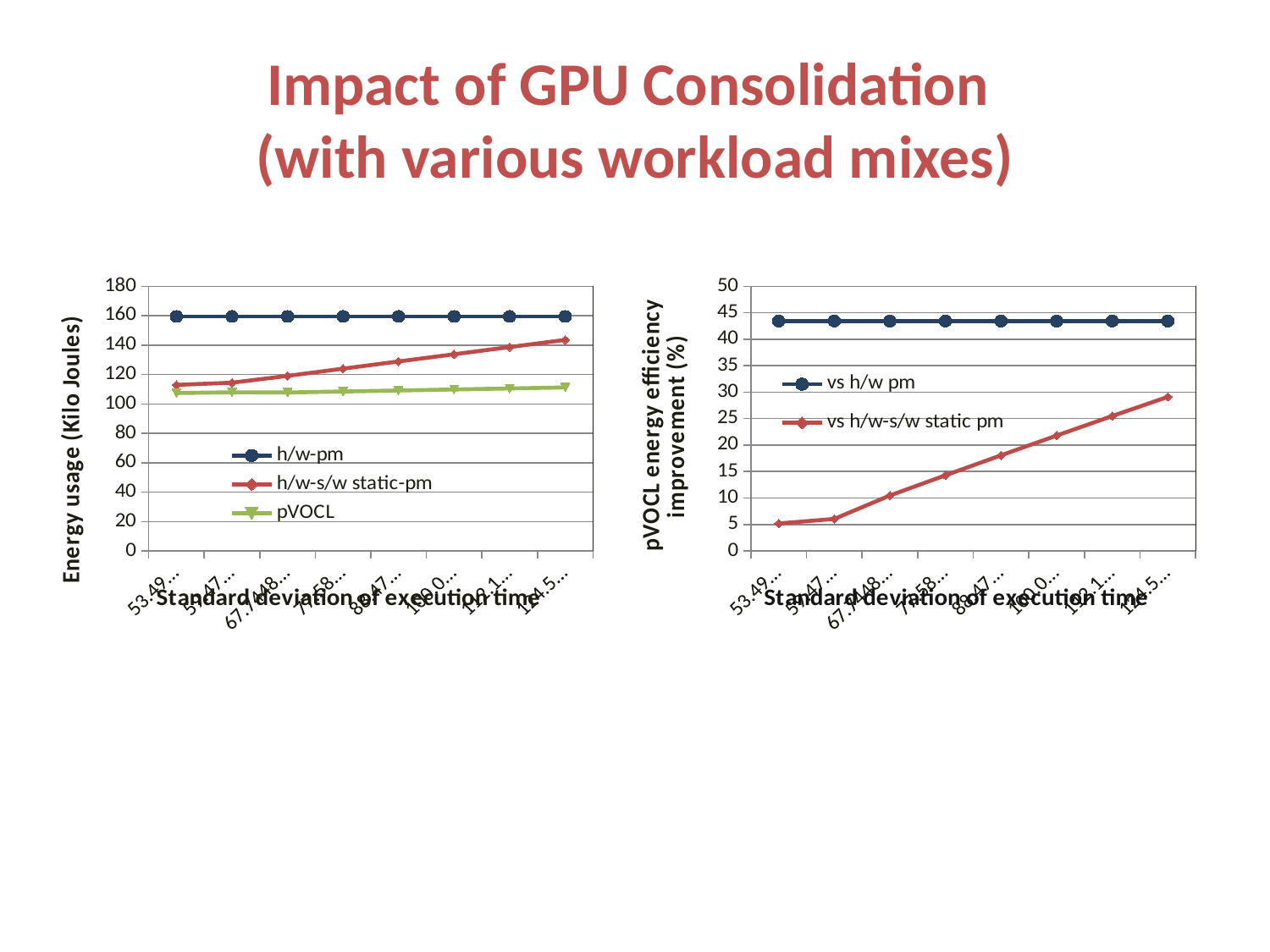
What is the y-axis label of the left chart? Energy usage (Kilo Joules) How many data points does each series have in the right chart (pVOCL energy efficiency improvement)? 8 How many series does the legend of the left chart (Energy usage) list? 3 In the right chart (pVOCL energy efficiency improvement), are the values for vs h/w pm greater or less than 40? greater In the left chart (Energy usage), which series has the highest energy usage? h/w-pm In the right chart (pVOCL energy efficiency improvement), does the vs h/w-s/w static pm series rise or fall along the x axis? rise In the left chart (Energy usage), are the values for h/w-pm greater or less than 140? greater How many series does the legend of the right chart (pVOCL energy efficiency improvement) list? 2 In the left chart (Energy usage), does the h/w-s/w static-pm series rise or fall along the x axis? rise What type of chart is the left chart (Energy usage)? line chart In the left chart (Energy usage), which series has the lowest energy usage? pVOCL In the left chart (Energy usage), does the h/w-pm series rise, fall, or stay flat along the x axis? stay flat